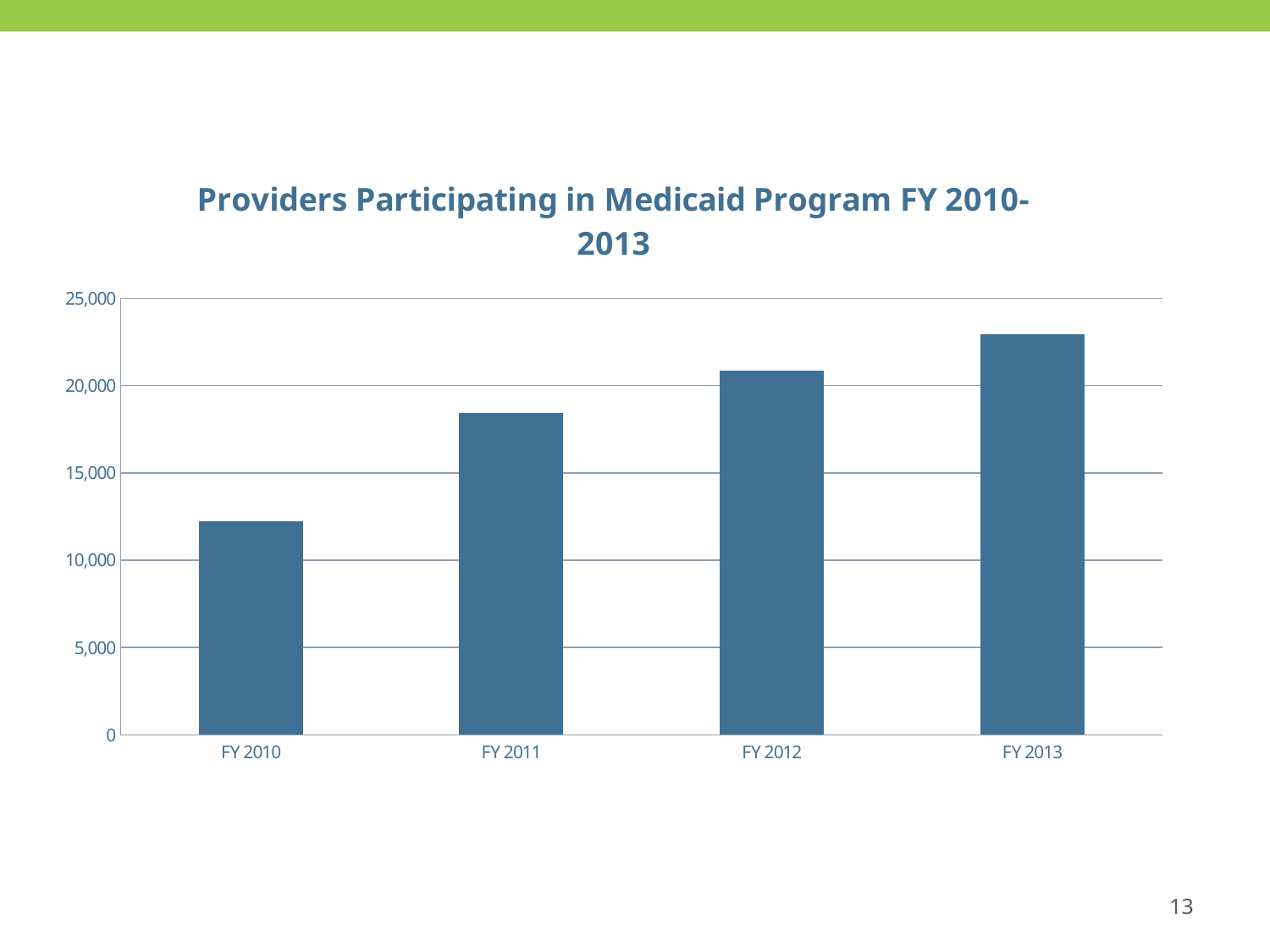
What is the title of the chart? Providers Participating in Medicaid Program FY 2010-2013 Is the value for FY 2011 greater or less than 15,000? greater Is the value for FY 2013 greater or less than 25,000? less What is the highest value shown on the y axis? 25,000 Is the value for FY 2010 greater or less than 15,000? less Which is larger, the value for FY 2011 or the value for FY 2012? FY 2012 Do the values rise or fall from FY 2010 to FY 2013? rise Which fiscal year has the lowest number of providers? FY 2010 What kind of chart is shown on the slide? bar chart Which fiscal year has the highest number of providers? FY 2013 How many fiscal years are shown on the x axis? 4